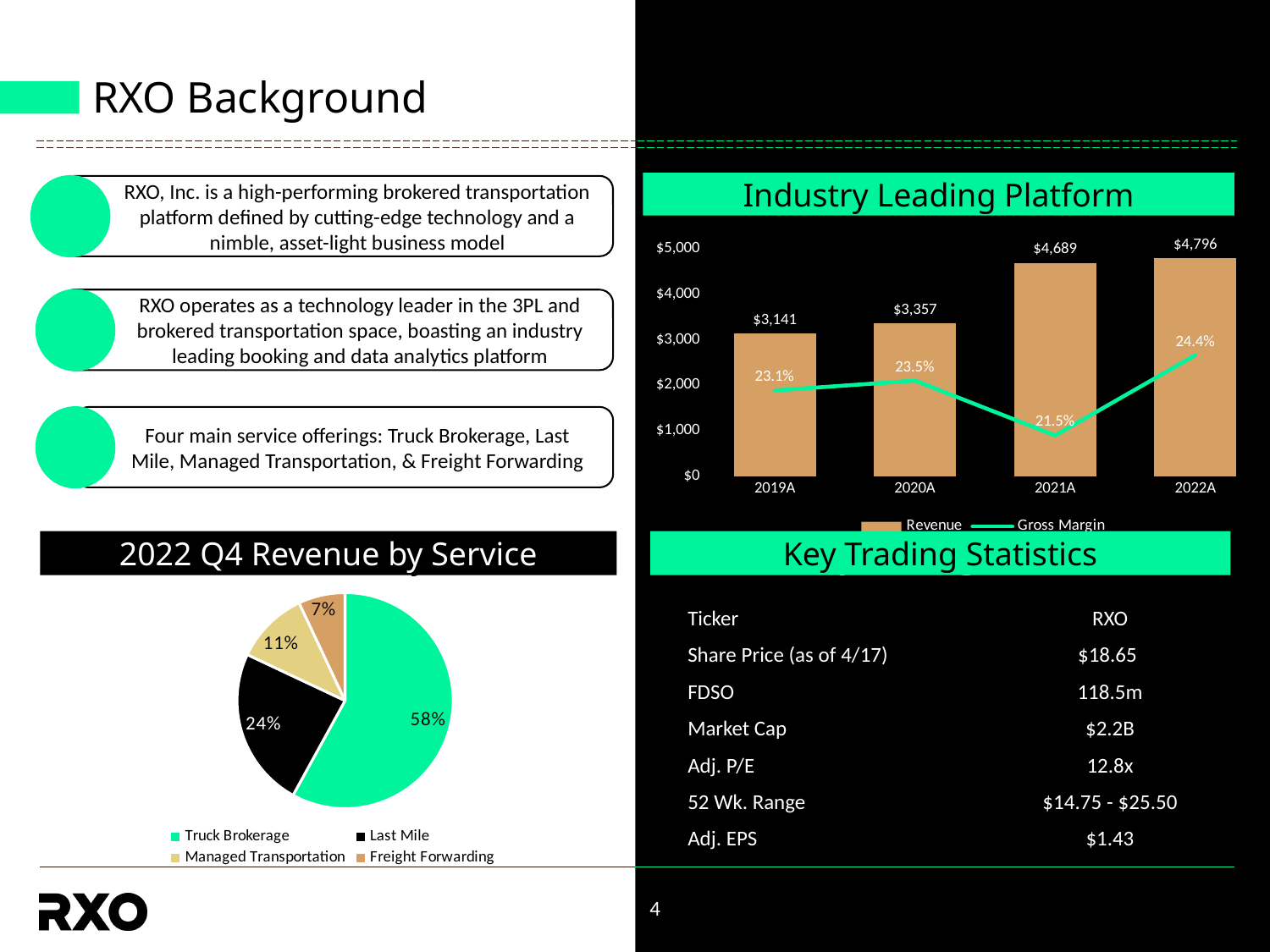
In the 2022 Q4 Revenue by Service chart, what share does Truck Brokerage have? 58% What kind of chart is the 2022 Q4 Revenue by Service chart? pie chart In the Industry Leading Platform chart, what is the gross margin for 2022A? 24.4% In the Industry Leading Platform chart, what is the revenue for 2021A? $4,689 In the Industry Leading Platform chart, which year has the highest revenue? 2022A In the Industry Leading Platform chart, which year has the lowest gross margin? 2021A In the 2022 Q4 Revenue by Service chart, which service has the smallest share? Freight Forwarding In the Industry Leading Platform chart, is the revenue for 2020A greater or less than $4,000? less In the Industry Leading Platform chart, how many series does the legend list? 2 In the Industry Leading Platform chart, what is the difference in revenue between 2020A and 2019A? $216 In the 2022 Q4 Revenue by Service chart, which is larger, Last Mile or Managed Transportation? Last Mile In the Industry Leading Platform chart, does revenue rise or fall from 2019A to 2022A? rise